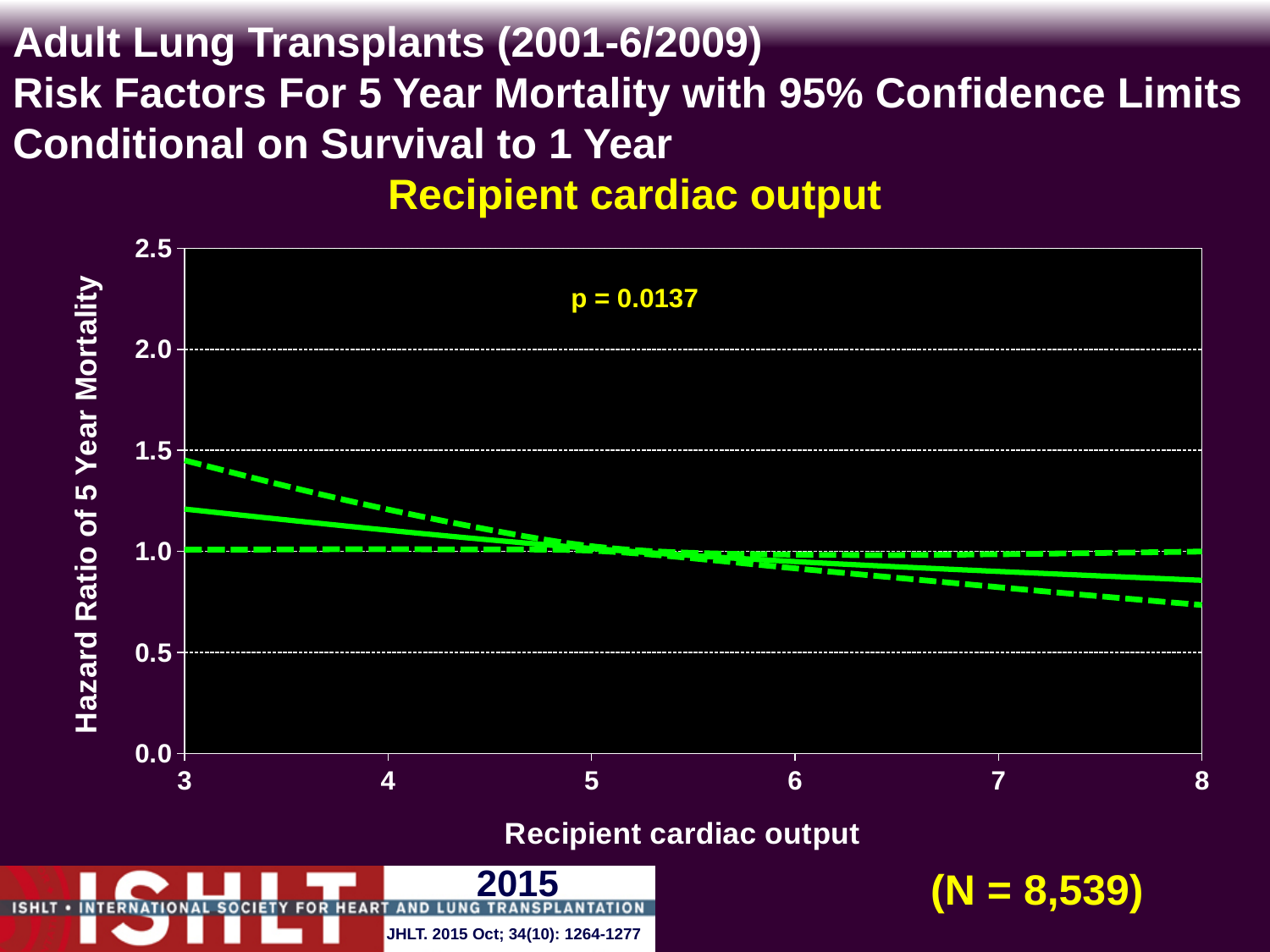
What kind of chart is shown on the slide? line chart What is the sample size (N) shown on the slide? N = 8,539 What p-value is printed on the chart? p = 0.0137 Is the lower confidence limit (lower dashed line) at a recipient cardiac output of 8 greater or less than 0.5? greater Is the hazard ratio (solid line) at a recipient cardiac output of 8 greater or less than 1.0? less What is the highest value shown on the y axis? 2.5 Is the upper confidence limit (upper dashed line) at a recipient cardiac output of 3 greater or less than 2.0? less How many lines are plotted on the chart? 3 Does the hazard ratio (solid line) rise or fall as recipient cardiac output increases from 3 to 8? fall